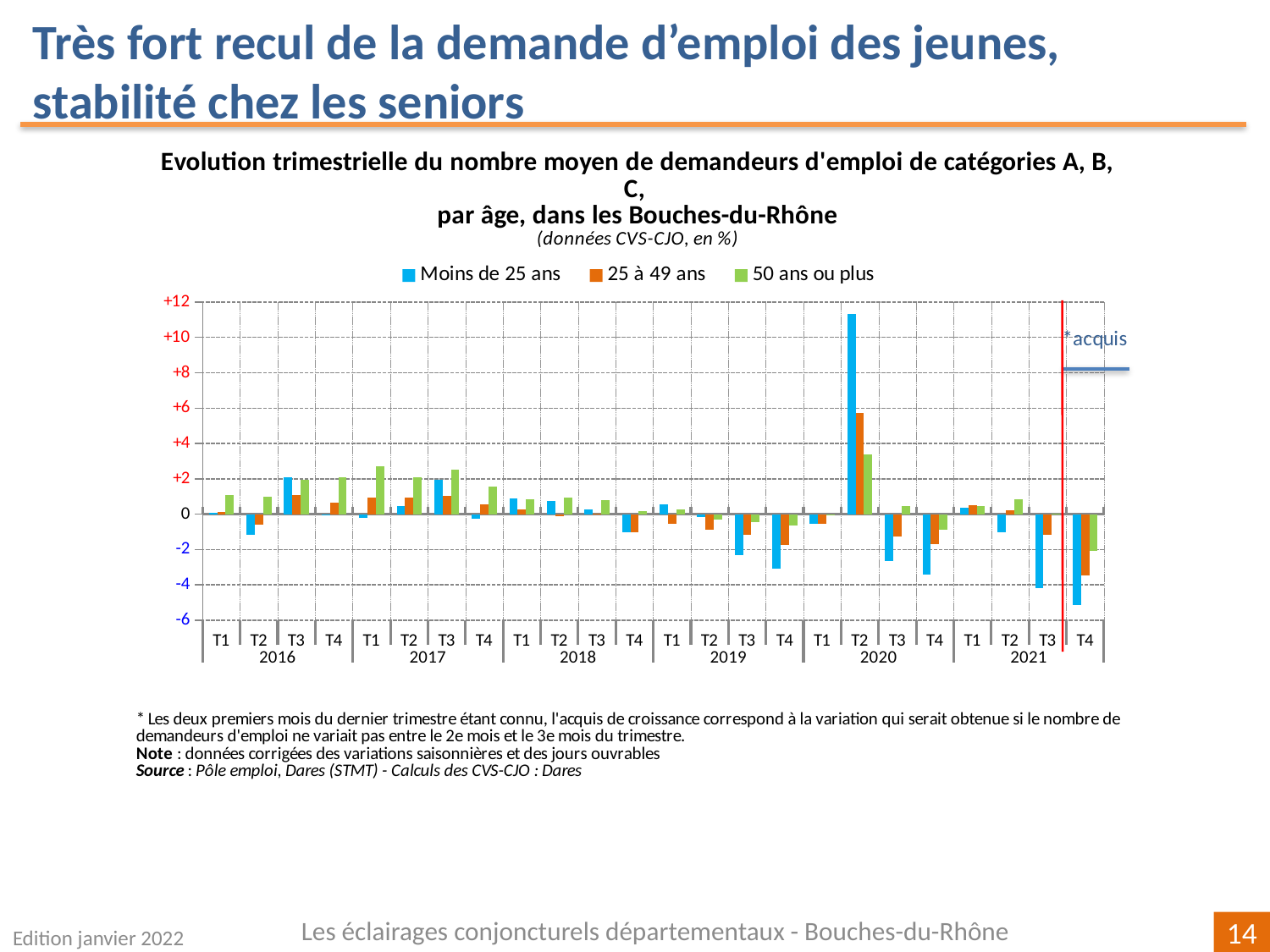
Is the value for 'Moins de 25 ans' in T4 2021 greater or less than -4? less In which quarter does the 'Moins de 25 ans' series reach its highest value? T2 2020 Is the value for '25 à 49 ans' in T2 2020 greater or less than +4? greater What kind of chart is shown on the slide? bar chart In T4 2021, which series has the larger value: 'Moins de 25 ans' or '50 ans ou plus'? 50 ans ou plus In which quarter does the 'Moins de 25 ans' series reach its lowest value? T4 2021 In T2 2020, which series has the larger value: 'Moins de 25 ans' or '25 à 49 ans'? Moins de 25 ans How many quarters are plotted along the x axis? 24 Which colour represents the 'Moins de 25 ans' series in the legend? blue Is the value for 'Moins de 25 ans' in T3 2021 greater or less than -2? less How many series does the legend list? 3